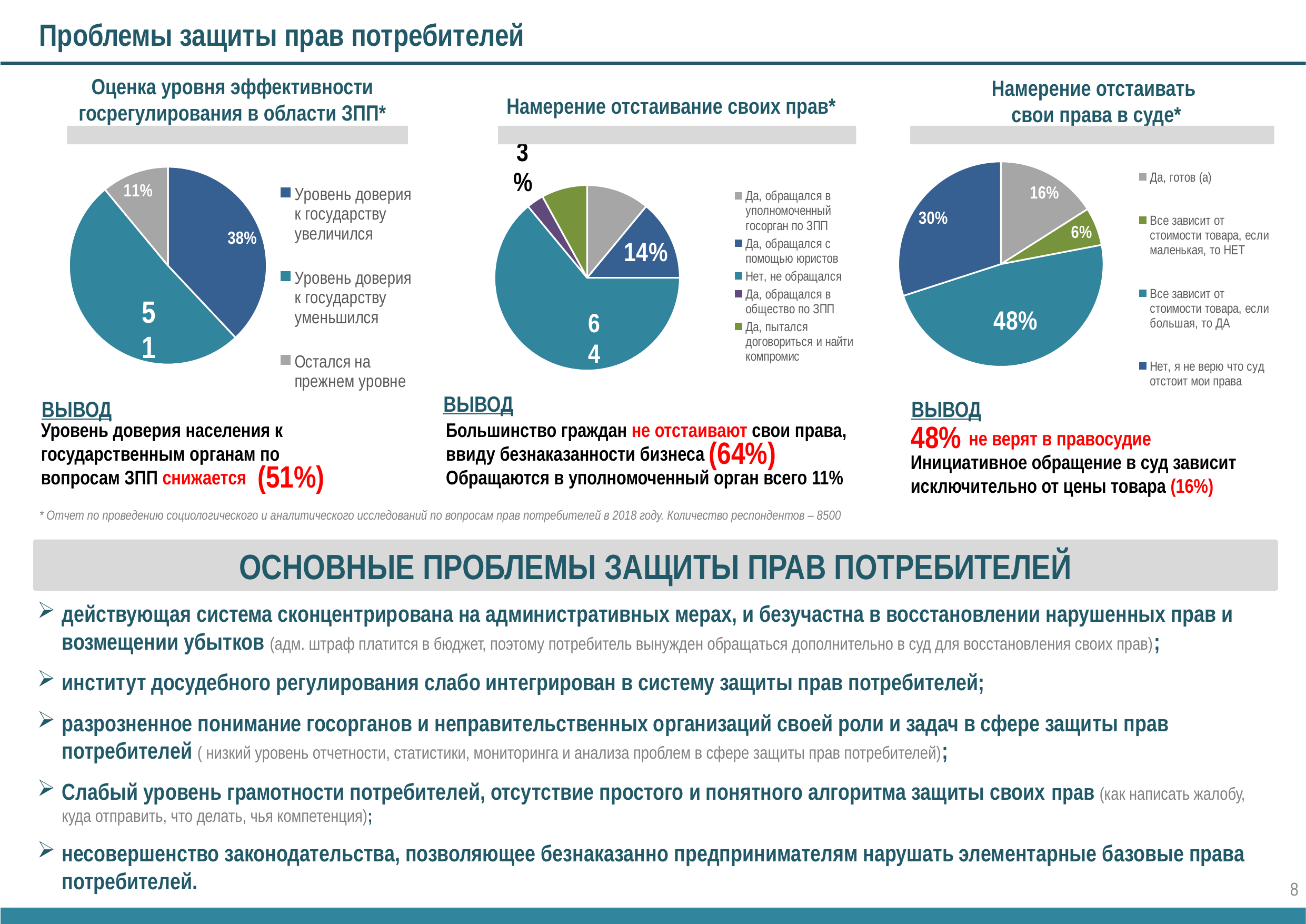
In the chart 'Намерение отстаивание своих прав*', which category has the largest slice? Нет, не обращался How many categories does the chart 'Намерение отстаивать свои права в суде*' show? 4 In the chart 'Оценка уровня эффективности госрегулирования в области ЗПП*', what share is shown for 'Остался на прежнем уровне'? 11% In the chart 'Намерение отстаивать свои права в суде*', what share is shown for 'Все зависит от стоимости товара, если большая, то ДА'? 48% In the chart 'Оценка уровня эффективности госрегулирования в области ЗПП*', what share is shown for 'Уровень доверия к государству увеличился'? 38% In the chart 'Намерение отстаивать свои права в суде*', what is the difference between the 48% slice and the 30% slice? 18 percentage points In the chart 'Намерение отстаивать свои права в суде*', what share is shown for 'Нет, я не верю что суд отстоит мои права'? 30% In the chart 'Намерение отстаивать свои права в суде*', which category has the smallest slice? Все зависит от стоимости товара, если маленькая, то НЕТ What type of chart is used for 'Намерение отстаивание своих прав*'? Pie chart In the chart 'Намерение отстаивание своих прав*', what share is shown for 'Да, обращался с помощью юристов'? 14% In the chart 'Намерение отстаивать свои права в суде*', which category has the largest slice? Все зависит от стоимости товара, если большая, то ДА In the chart 'Оценка уровня эффективности госрегулирования в области ЗПП*', which category has the largest slice? Уровень доверия к государству уменьшился